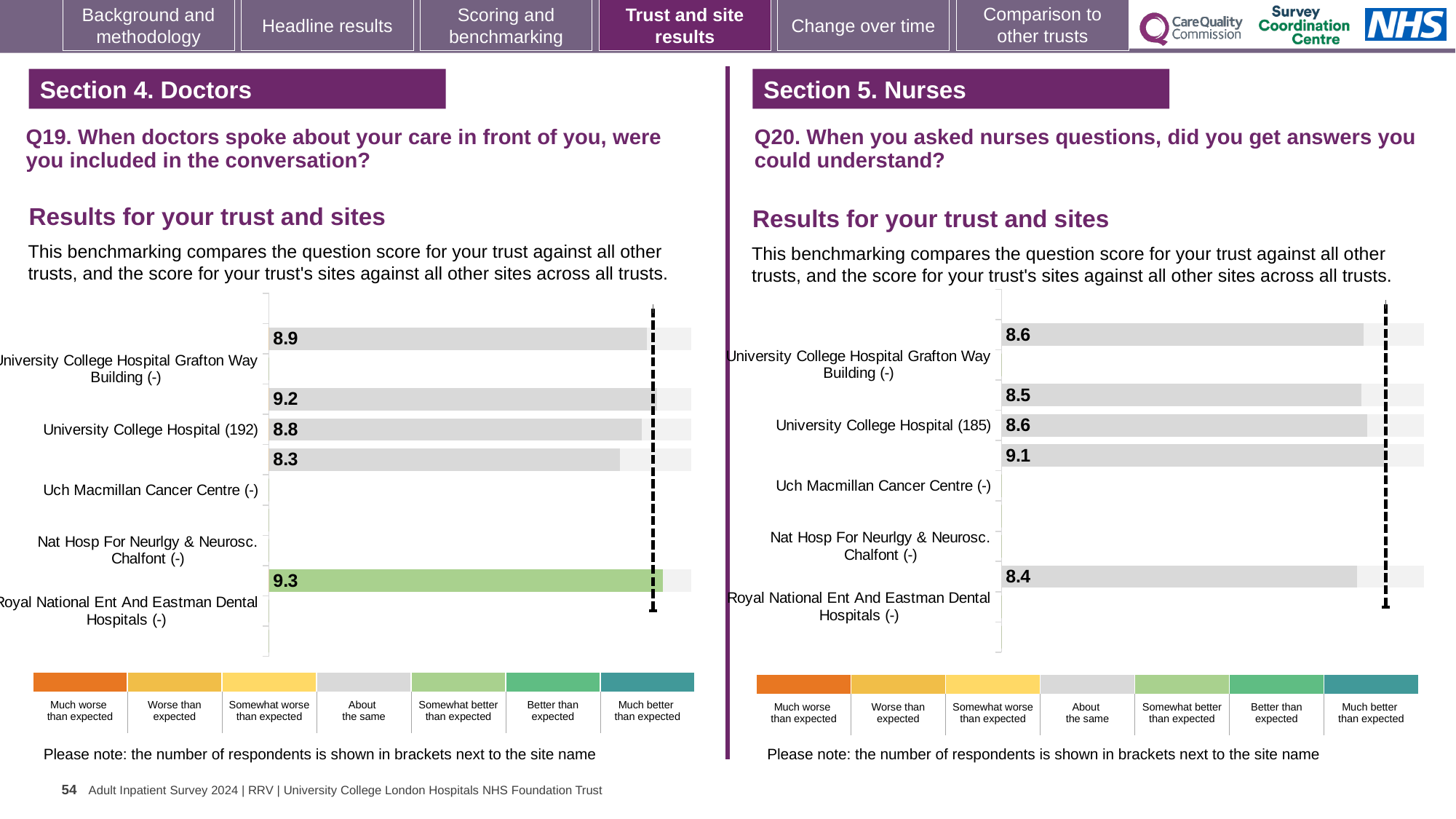
On the left chart (Q19), what is the difference between the highest score (9.3) and the lowest score (8.3)? 1.0 On the right chart (Q20), what is the lowest score shown? 8.4 On the left chart (Q19), what is the score for University College Hospital (192)? 8.8 On the right chart (Q20), what is the highest score shown? 9.1 On the right chart (Q20), what is the difference between the highest score (9.1) and the lowest score (8.4)? 0.7 On the left chart (Q19), what colour is the bar with the score 9.3? green On the right chart (Q20), what is the score for University College Hospital (185)? 8.6 On the left chart (Q19), how many bars have a score label printed? 5 Which is larger: the score for University College Hospital on the left chart (Q19) or on the right chart (Q20)? left chart (Q19), 8.8 What type of chart is shown on the left (Q19) side of the slide? bar chart On the left chart (Q19), what is the highest score shown? 9.3 On the left chart (Q19), what is the lowest score shown? 8.3